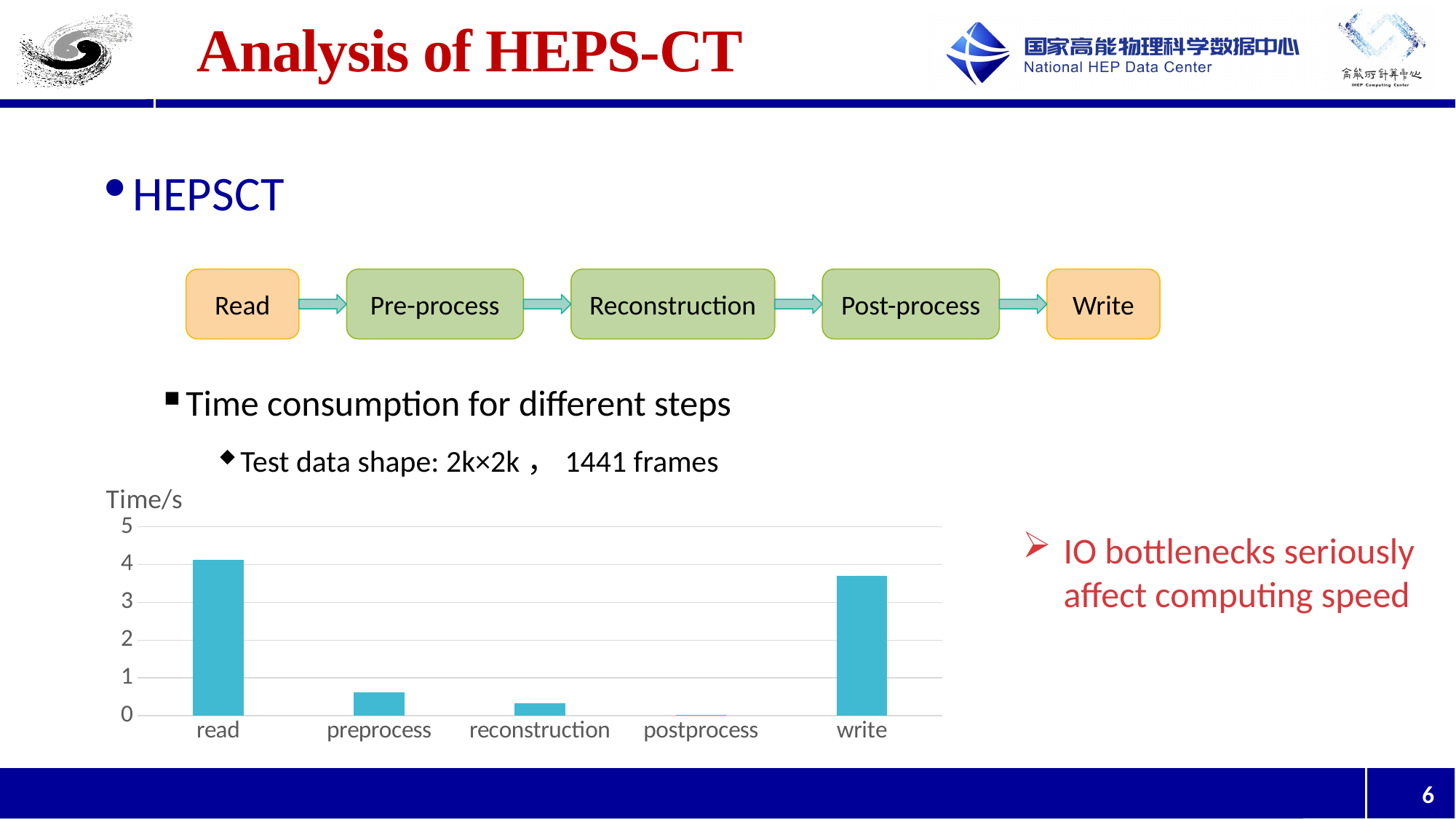
Is the value for preprocess greater or less than 1? less Which has a larger value in the chart, preprocess or reconstruction? preprocess How many categories are shown on the x axis of the chart? 5 What is the label of the y axis of the chart? Time/s Which has a larger value in the chart, read or write? read Which step has the lowest time consumption in the chart? postprocess What kind of chart is shown on the slide? bar chart Is the value for write greater or less than 3? greater Is the value for write greater or less than 4? less Which step has the highest time consumption in the chart? read What is the highest tick value shown on the y axis of the chart? 5